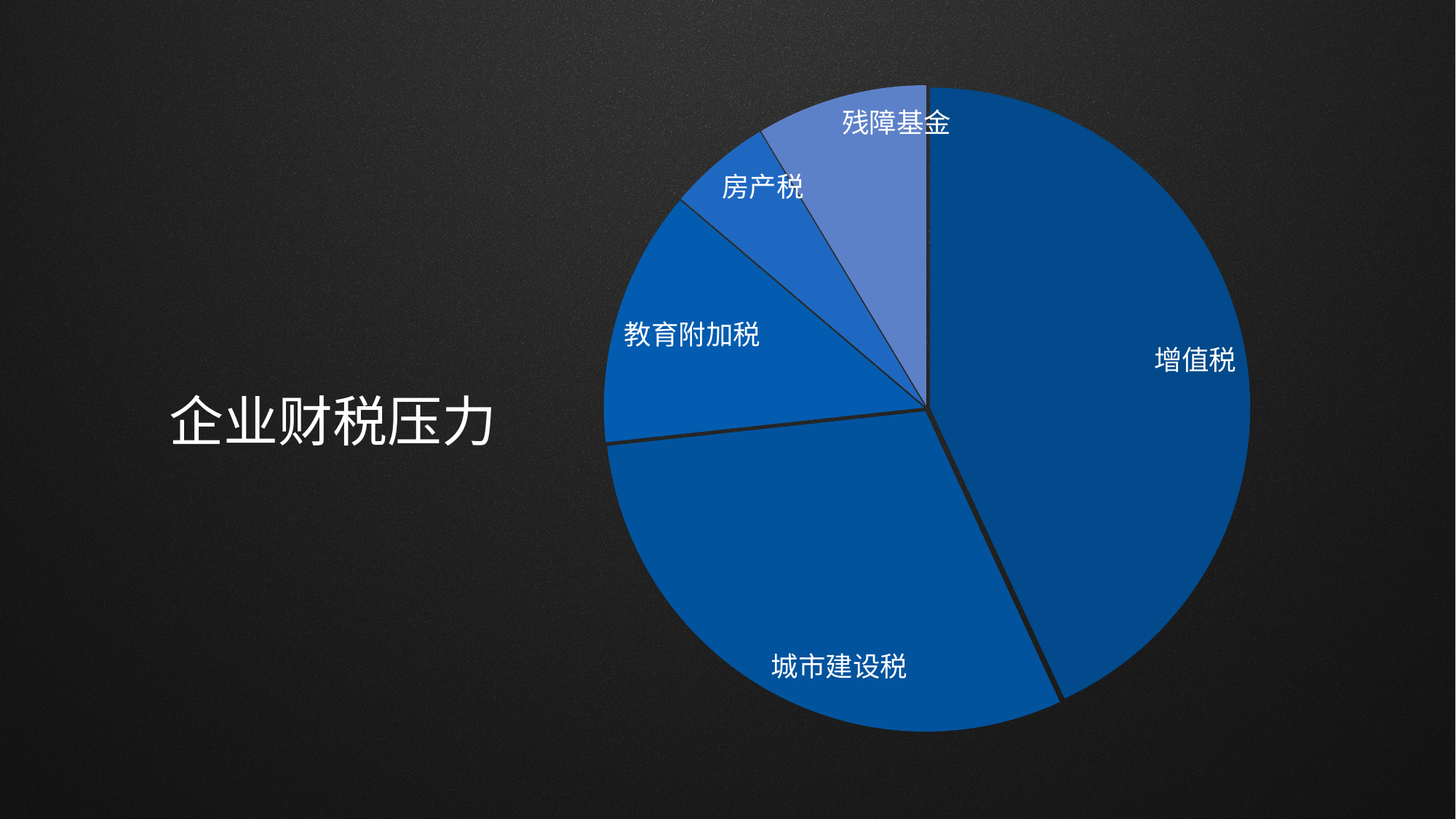
Which slice of the pie chart is drawn in the lightest shade of blue? 残障基金 Which category has the smallest slice of the pie chart? 房产税 Which slice is larger, 城市建设税 or 教育附加税? 城市建设税 Which category has the largest slice of the pie chart? 增值税 Which slice is larger, 增值税 or 城市建设税? 增值税 What kind of chart is shown on the slide? Pie chart How many slices does the pie chart have? 5 Which slice is larger, 残障基金 or 房产税? 残障基金 Which category has the second-largest slice of the pie chart? 城市建设税 What is the title shown on the slide next to the pie chart? 企业财税压力